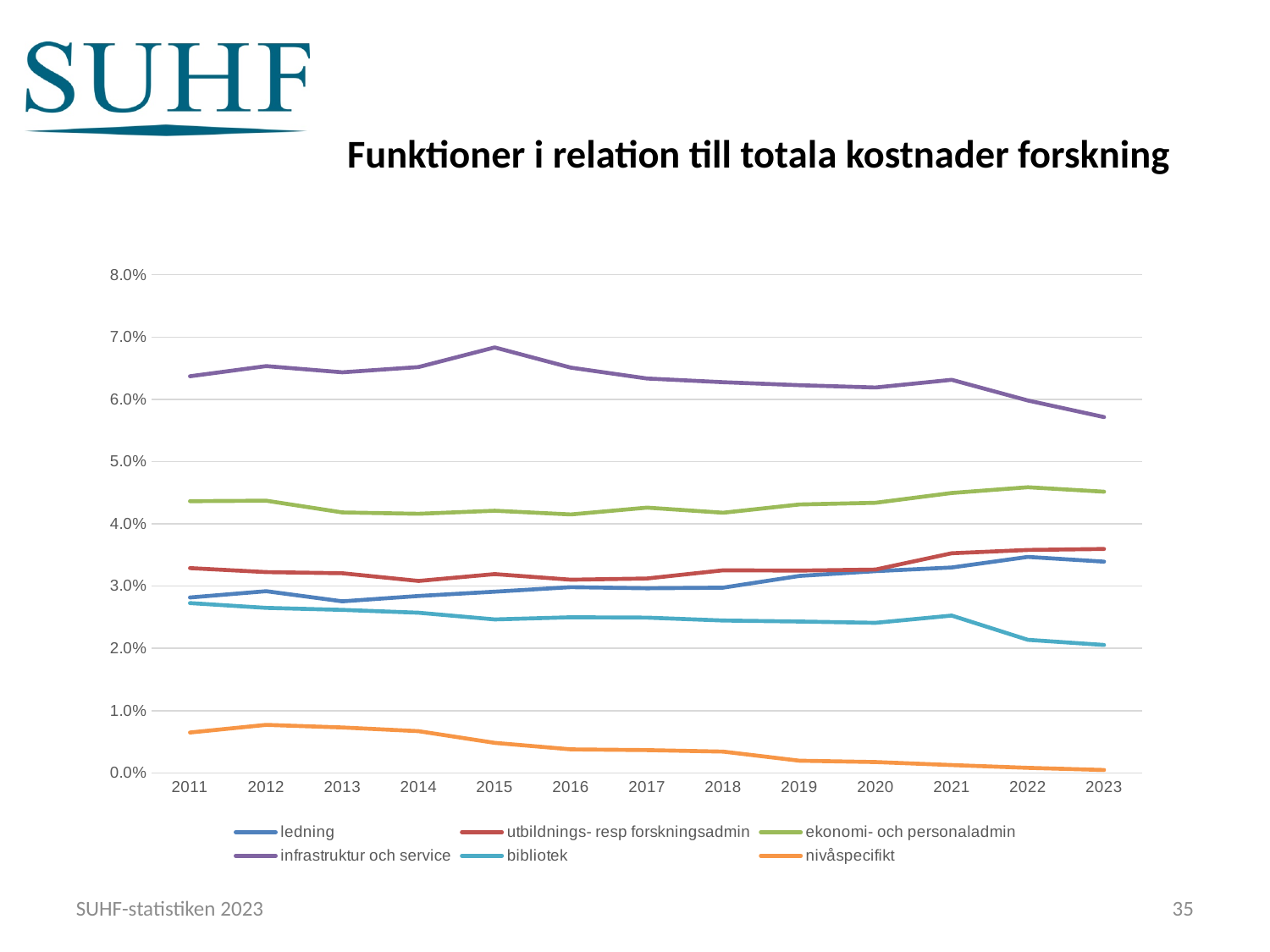
What kind of chart is shown on the slide? line chart Is the value for bibliotek in 2023 greater or less than 3.0%? less What is the title of the chart? Funktioner i relation till totala kostnader forskning Does the nivåspecifikt series rise or fall from 2011 to 2023? fall Is the value for ekonomi- och personaladmin in 2022 greater or less than 4.0%? greater Which series has the lowest values across all years? nivåspecifikt Is the value for nivåspecifikt in 2023 greater or less than 1.0%? less In 2023, which is larger: ledning or bibliotek? ledning Which series has the highest values across all years? infrastruktur och service How many years are plotted along the x axis? 13 How many series does the legend list? 6